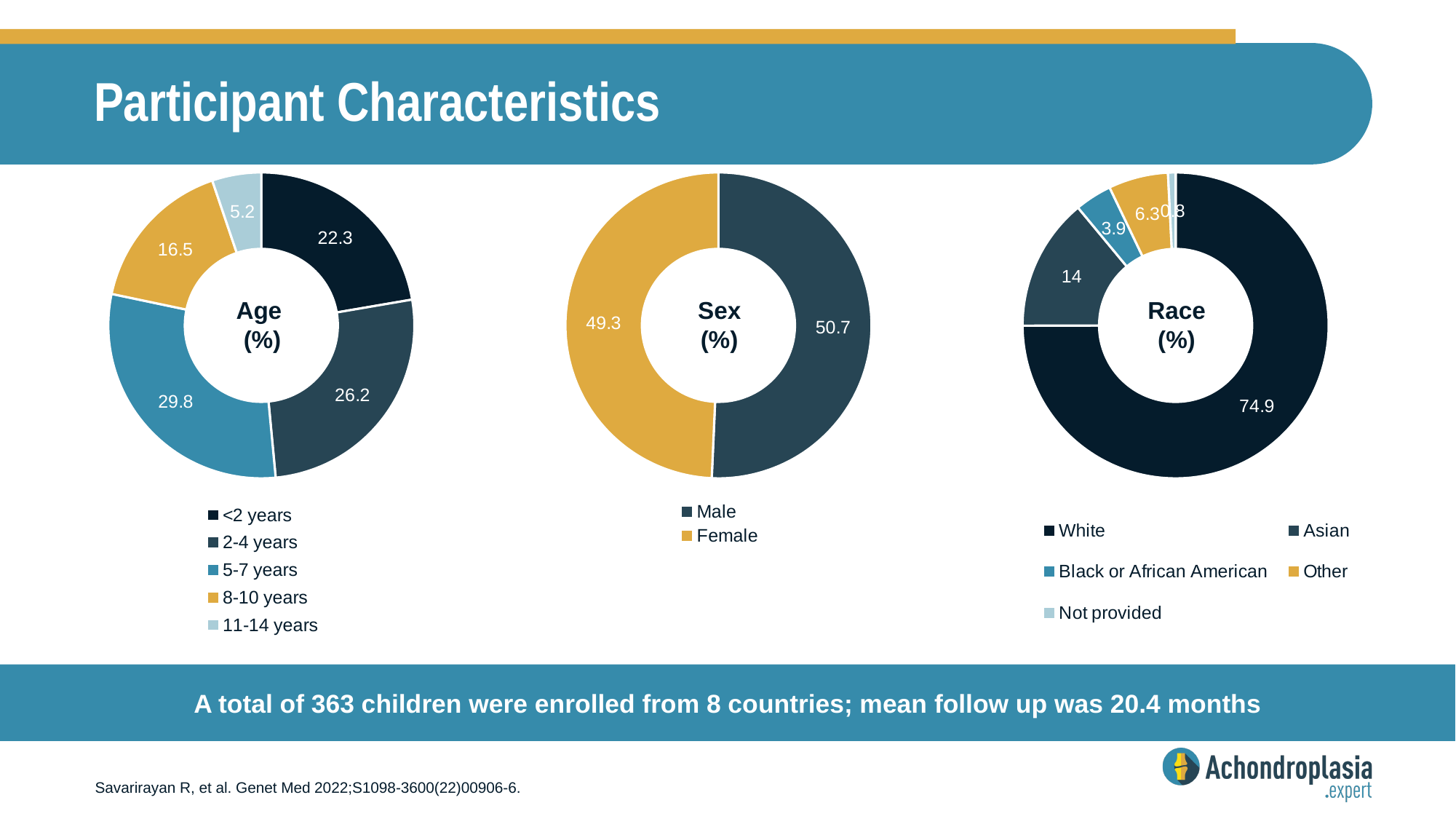
In the Sex (%) chart, what is the value for Female? 49.3 In the Sex (%) chart, which is larger, Male or Female? Male How many entries does the legend of the Race (%) chart list? 5 In the Age (%) chart, which age group has the smallest share? 11-14 years In the Age (%) chart, what is the difference between the values for 2-4 years and 8-10 years? 9.7 In the Race (%) chart, what is the value for White? 74.9 What kind of chart is the Sex (%) chart? Pie chart (donut) In the Age (%) chart, which age group has the largest share? 5-7 years In the Race (%) chart, what is the value for Asian? 14 How many categories does the Age (%) chart show? 5 In the Age (%) chart, what is the value for 5-7 years? 29.8 In the Race (%) chart, what is the difference between the values for Other and Black or African American? 2.4